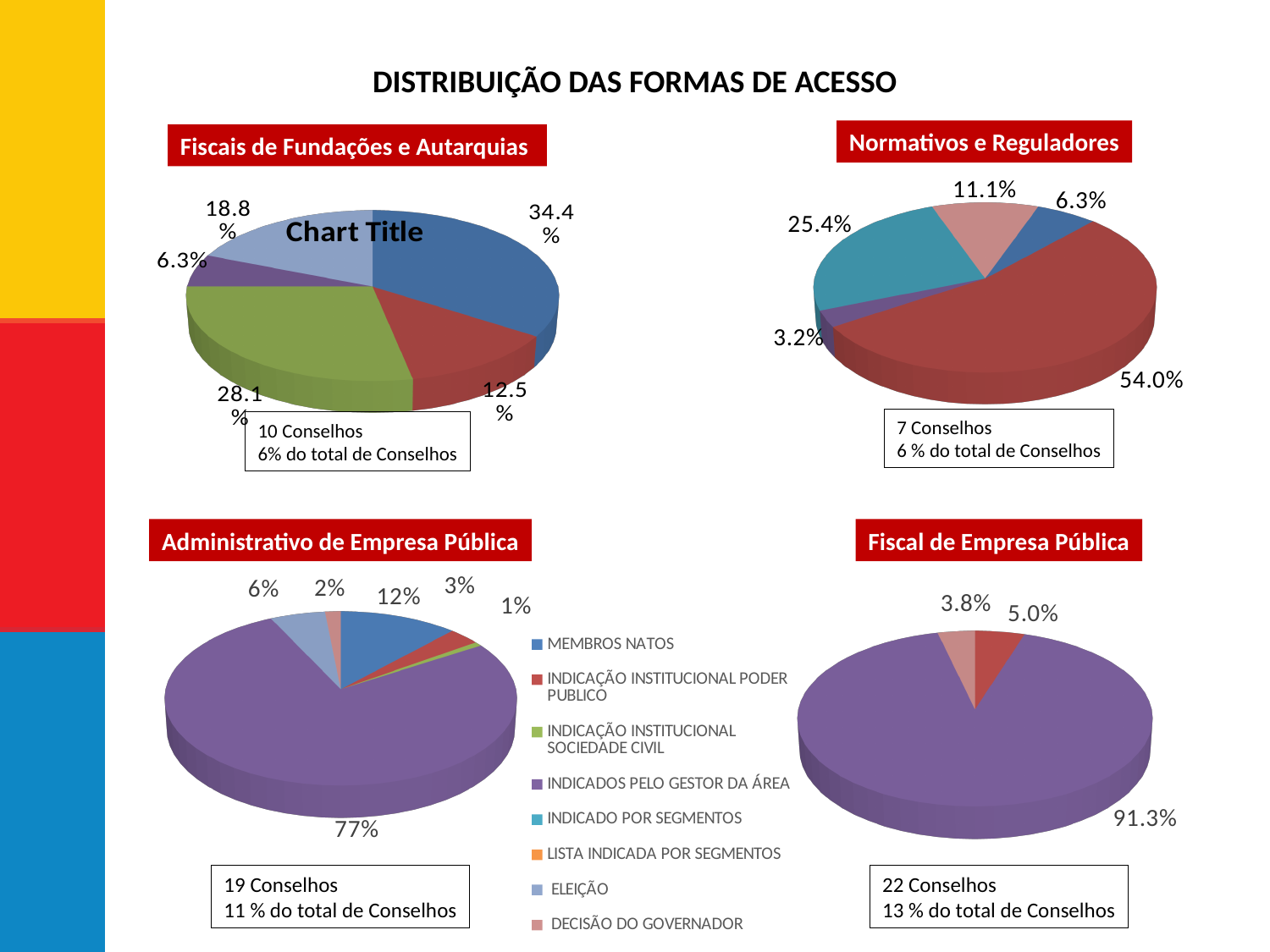
In the 'Normativos e Reguladores' chart, what is the difference between the 54.0% slice and the 25.4% slice? 28.6% In the 'Fiscal de Empresa Pública' chart, what is the largest slice's percentage? 91.3% In the 'Fiscal de Empresa Pública' chart, which is larger, the 3.8% slice or the 5.0% slice? 5.0% In the 'Normativos e Reguladores' chart, what is the largest slice's percentage? 54.0% In the 'Fiscais de Fundações e Autarquias' chart, what is the smallest slice's percentage? 6.3% In the 'Fiscais de Fundações e Autarquias' chart, what is the largest slice's percentage? 34.4% In the 'Normativos e Reguladores' chart, what is the smallest slice's percentage? 3.2% How many slices does the 'Fiscais de Fundações e Autarquias' pie chart have? 5 How many entries does the legend on the slide list? 8 What type of charts are shown on the slide? Pie charts